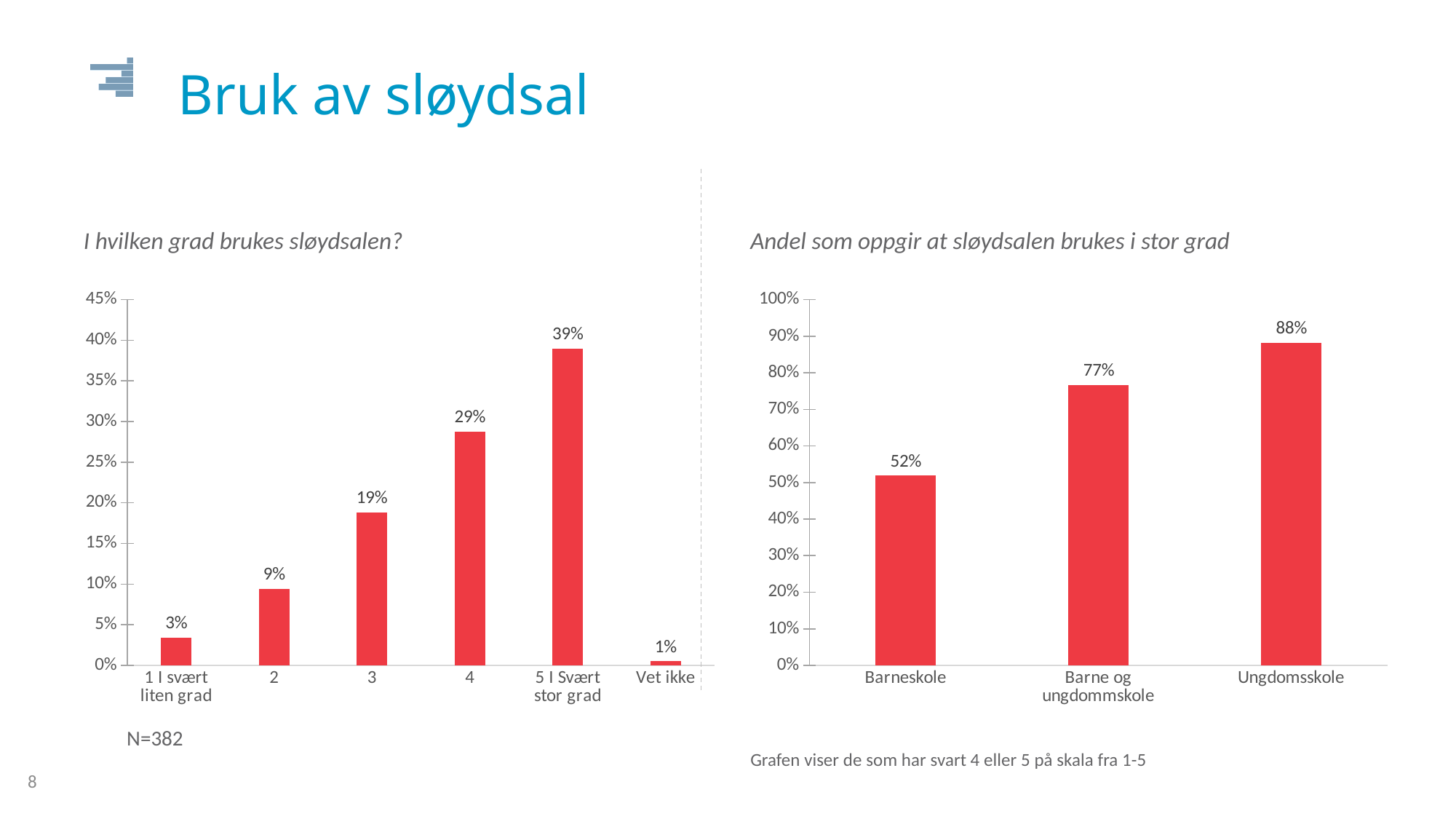
In the right chart 'Andel som oppgir at sløydsalen brukes i stor grad', which is larger, Barne og ungdommskole or Barneskole? Barne og ungdommskole In the right chart 'Andel som oppgir at sløydsalen brukes i stor grad', which category has the highest value? Ungdomsskole In the right chart 'Andel som oppgir at sløydsalen brukes i stor grad', what is the difference between Ungdomsskole and Barneskole? 36% In the left chart 'I hvilken grad brukes sløydsalen?', what is the difference between the values for category 4 and category 2? 20% In the left chart 'I hvilken grad brukes sløydsalen?', which category has the lowest value? Vet ikke What kind of chart is the right chart 'Andel som oppgir at sløydsalen brukes i stor grad'? Bar chart In the left chart 'I hvilken grad brukes sløydsalen?', which category has the highest value? 5 I Svært stor grad In the left chart 'I hvilken grad brukes sløydsalen?', how many categories are shown on the x axis? 6 In the left chart 'I hvilken grad brukes sløydsalen?', what is the value for category 3? 19% In the right chart 'Andel som oppgir at sløydsalen brukes i stor grad', do the values rise or fall from left to right? Rise In the right chart 'Andel som oppgir at sløydsalen brukes i stor grad', what is the value for Barneskole? 52% In the left chart 'I hvilken grad brukes sløydsalen?', what is the value for '5 I Svært stor grad'? 39%